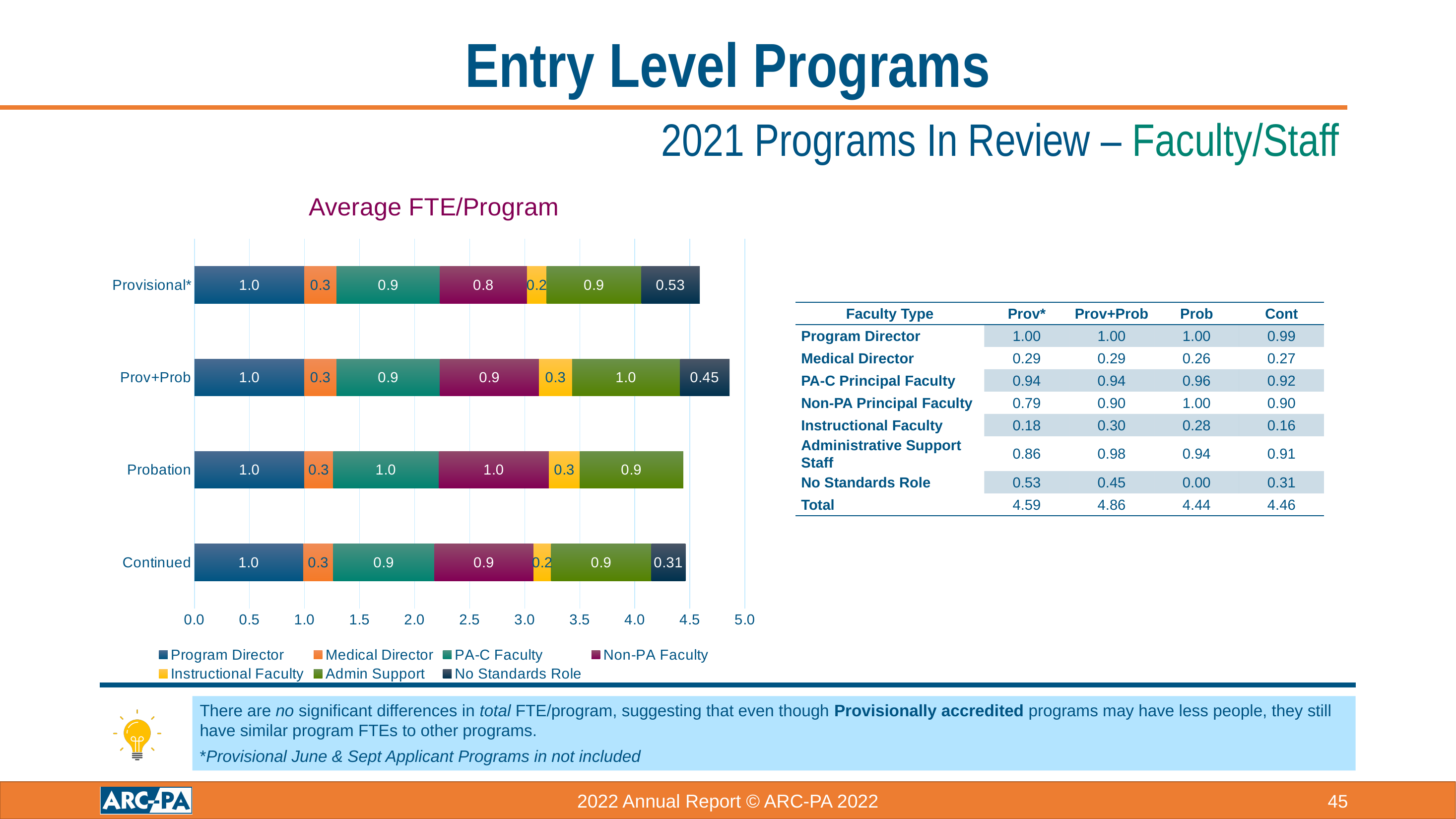
What colour represents Instructional Faculty in the Average FTE/Program chart legend? Yellow What kind of chart is shown under the title "Average FTE/Program"? Stacked bar chart In the Average FTE/Program chart, which program category has the longest total bar? Prov+Prob How many program categories are plotted in the Average FTE/Program chart? 4 In the Average FTE/Program chart, what is the No Standards Role value for Provisional*? 0.53 In the Average FTE/Program chart, what is the Admin Support value for Prov+Prob? 1.0 In the Average FTE/Program chart, what is the Non-PA Faculty value for Provisional*? 0.8 In the Average FTE/Program chart, is the No Standards Role value larger for Provisional* or for Continued? Provisional* How many series does the legend of the Average FTE/Program chart list? 7 In the Average FTE/Program chart, what is the No Standards Role value for Continued? 0.31 In the Average FTE/Program chart, what is the difference between the No Standards Role values for Provisional* and Continued? 0.22 In the Average FTE/Program chart, is the total bar length for Prov+Prob greater or less than 4.5? greater